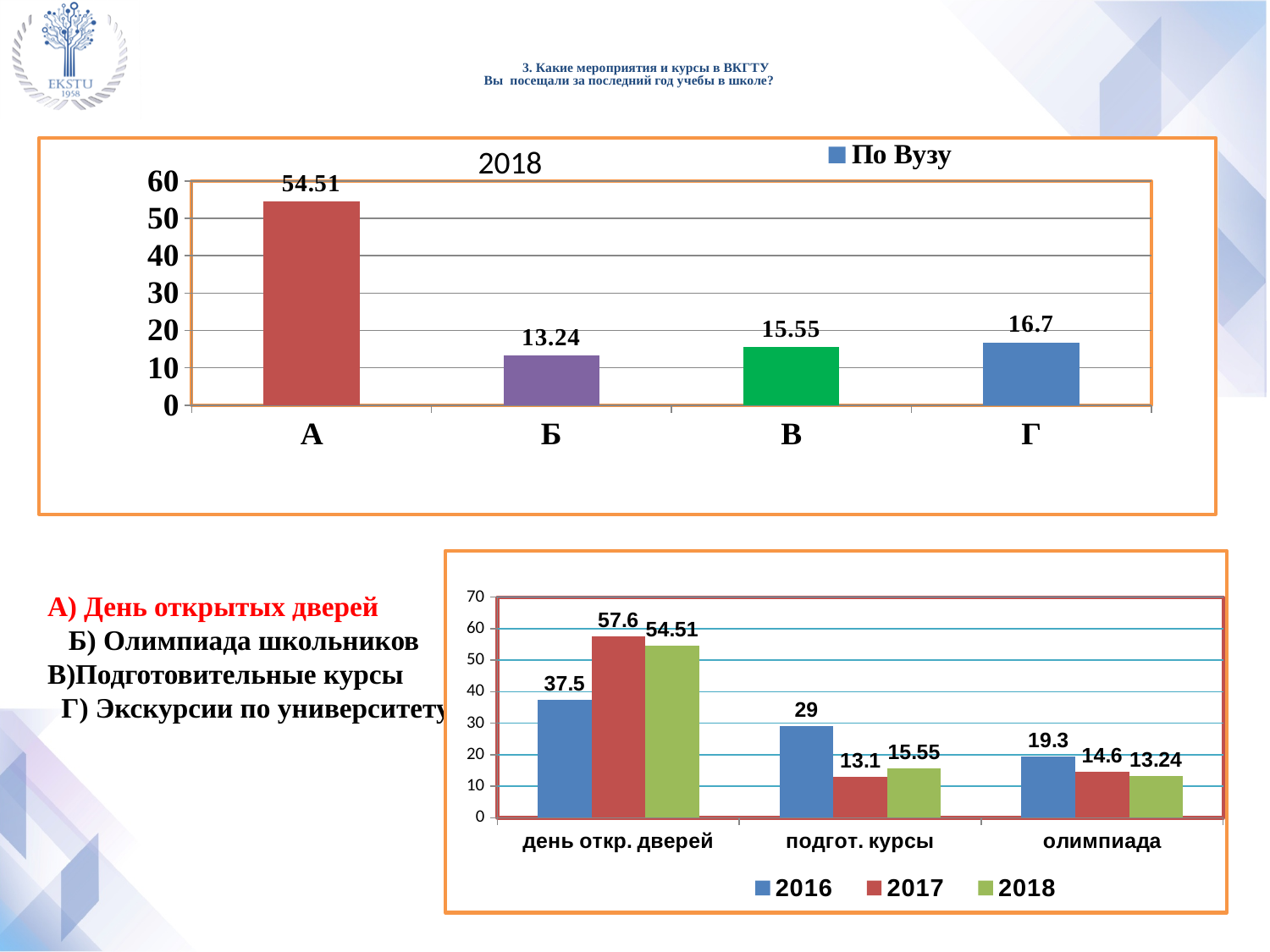
In the top chart titled "2018", what is the legend entry? По Вузу In the top chart titled "2018", what is the value for category Г? 16.7 In the top chart titled "2018", what is the difference between the values for А and В? 38.96 In the bottom chart, what is the value for 2016 in the category "подгот. курсы"? 29 In the top chart titled "2018", what is the value for category А? 54.51 In the bottom chart, what is the difference between the 2017 and 2018 values for "подгот. курсы"? 2.45 In the top chart titled "2018", how many categories are shown on the x axis? 4 In the bottom chart, what is the value for 2017 in the category "день откр. дверей"? 57.6 In the top chart titled "2018", which category has the lowest value? Б In the bottom chart, which is larger for "олимпиада": the 2016 value or the 2018 value? 2016 In the bottom chart, how many series does the legend list? 3 What kind of chart is the bottom chart? bar chart